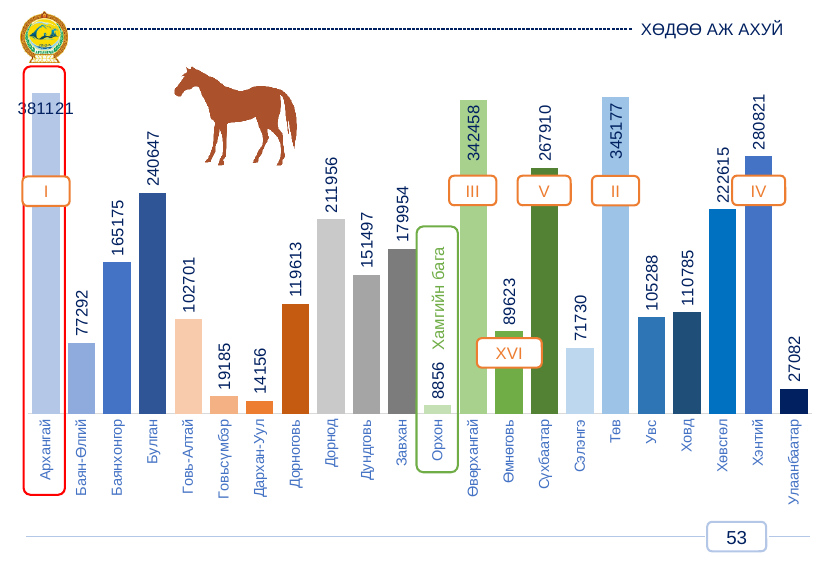
What kind of chart is shown on the slide? Bar chart What is the value shown for Хэнтий? 280821 Which category is marked with the label 'Хамгийн бага'? Орхон What is the value shown for Архангай? 381121 What is the difference between the values for Булган and Дорнод? 28691 How many categories are shown in the chart? 22 What is the value shown for Орхон? 8856 Which is larger, the value for Сүхбаатар or the value for Хөвсгөл? Сүхбаатар What is the difference between the values for Төв and Өвөрхангай? 2719 What is the value shown for Өвөрхангай? 342458 Which category has the highest value? Архангай Which category has the lowest value? Орхон